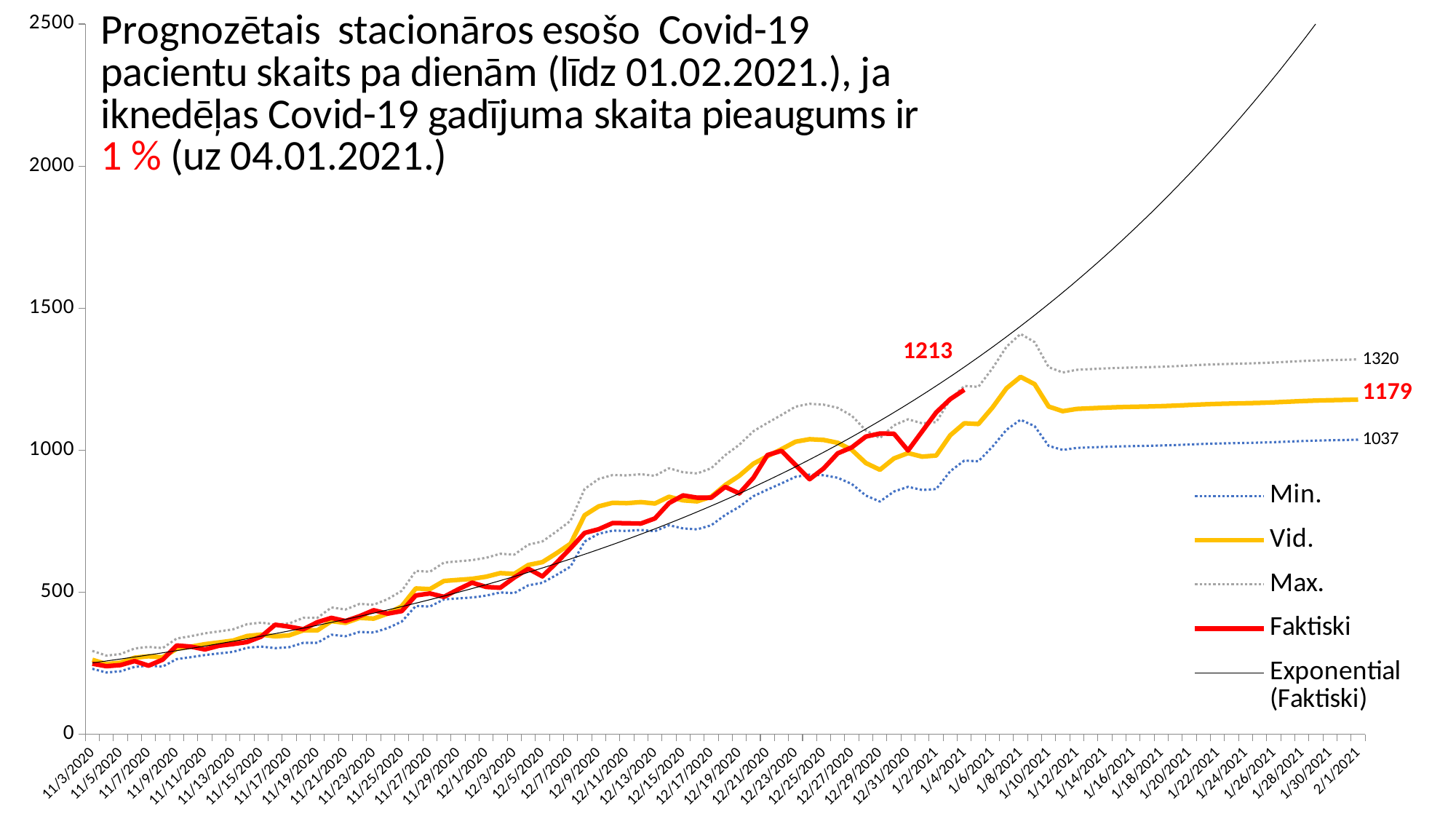
Is the value of the Exponential (Faktiski) series at 2/1/2021 greater or less than 2000? greater What kind of chart is shown on the slide? line chart Does the Faktiski series generally rise or fall from 11/3/2020 to 1/4/2021? rise Is the value of the Faktiski series on 11/3/2020 greater or less than 500? less What is the labelled value of the Max. series at 2/1/2021? 1320 What is the labelled value of the Vid. series at 2/1/2021? 1179 How many series does the legend list? 5 What is the labelled value at the end of the Faktiski series? 1213 What is the difference between the Max. and Vid. values labelled at 2/1/2021? 141 What is the labelled value of the Min. series at 2/1/2021? 1037 At 2/1/2021, which is larger: the Max. value or the Vid. value? Max. What is the difference between the Max. and Min. values labelled at 2/1/2021? 283